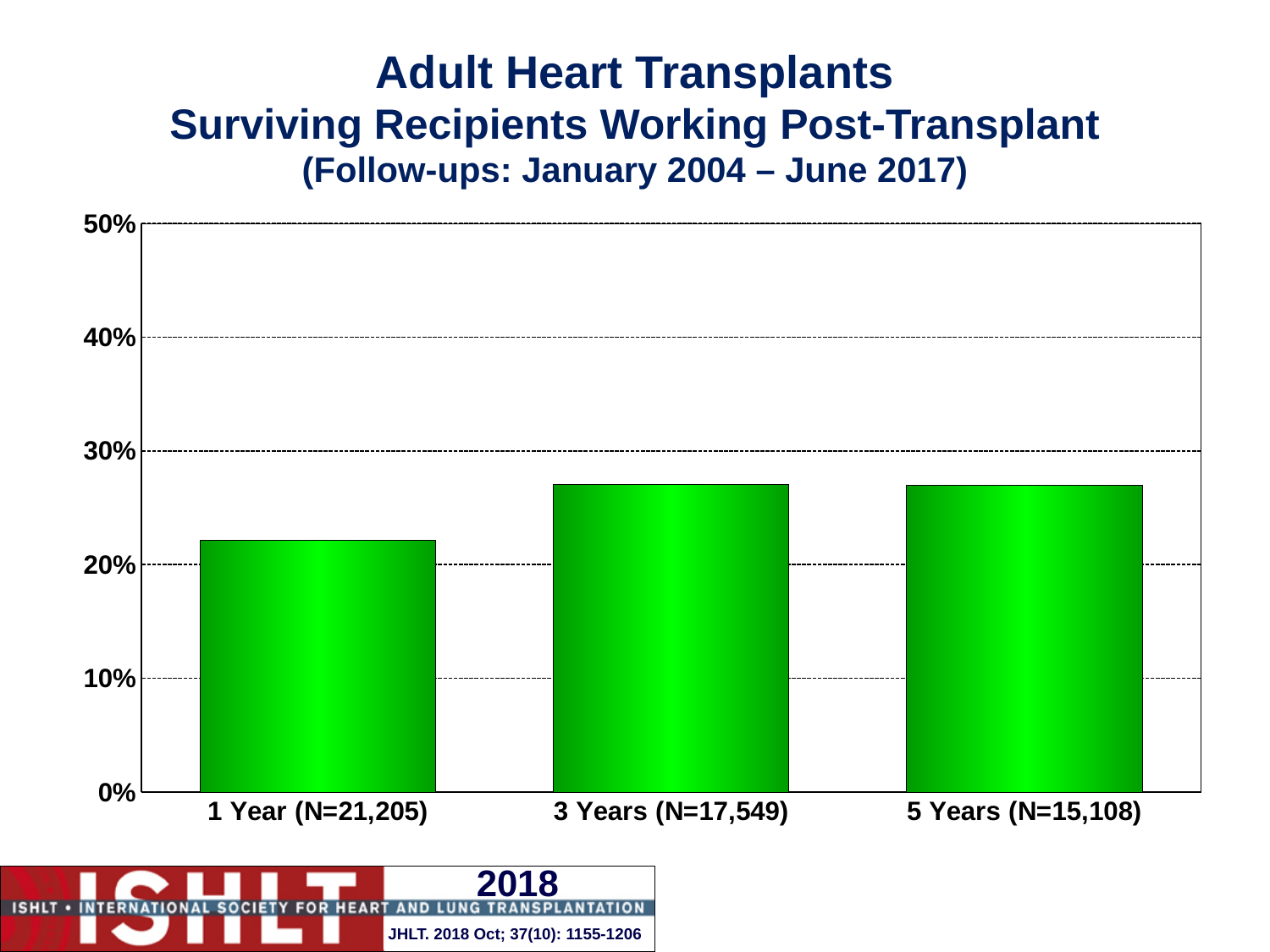
Which is larger, the value for 5 Years or the value for 1 Year? 5 Years Is the value for 1 Year greater or less than 20%? greater Which follow-up time point has the lowest percentage of surviving recipients working post-transplant? 1 Year (N=21,205) Is the value for 1 Year greater or less than 30%? less Is the value for 3 Years greater or less than 30%? less How many categories (follow-up time points) are shown on the x axis? 3 What is the number of recipients (N) for the 1 Year category? 21,205 What kind of chart is shown on the slide? bar chart Which is larger, the value for 1 Year or the value for 3 Years? 3 Years What is the highest value shown on the y axis? 50%